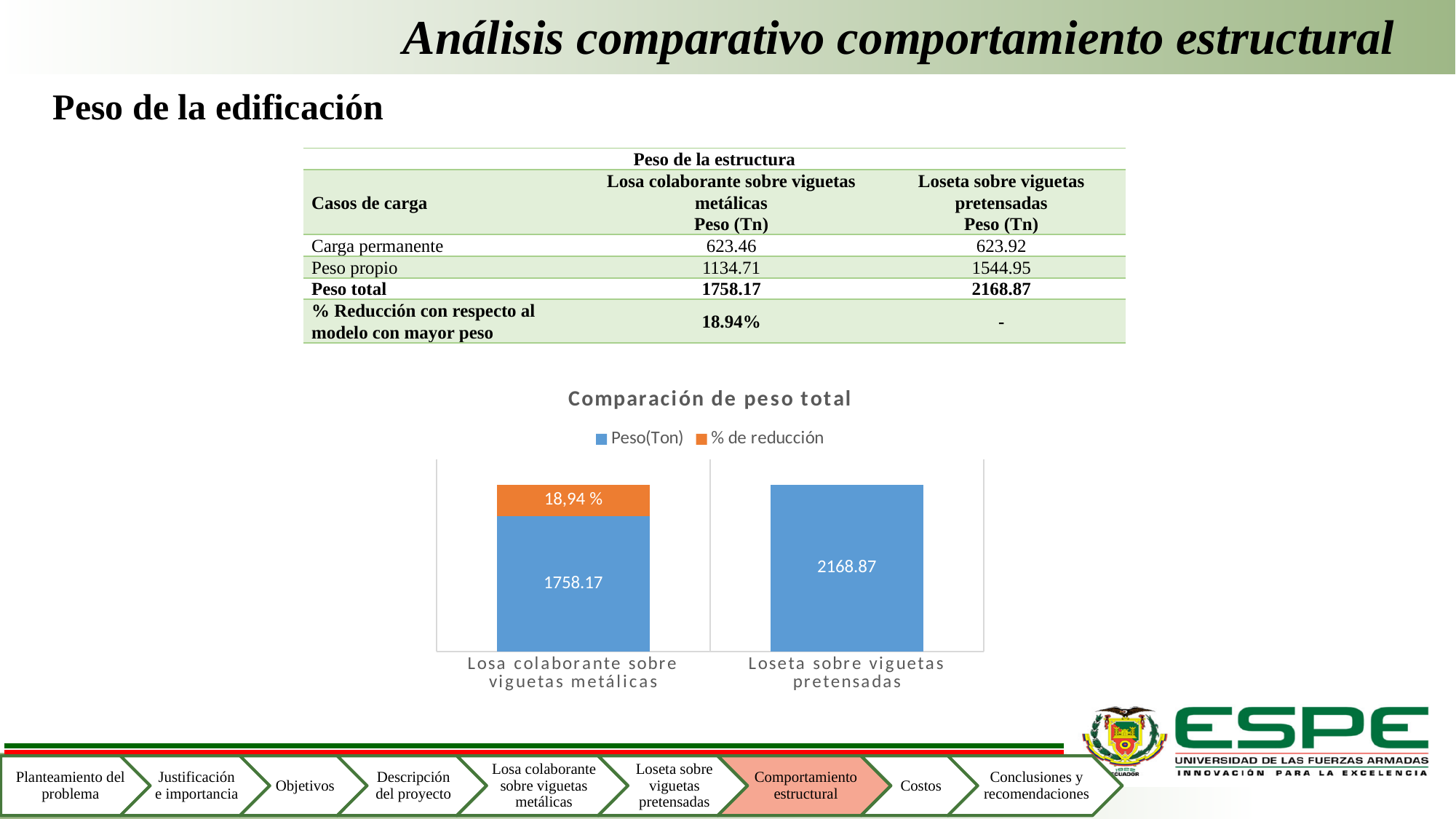
Which has a larger Peso(Ton) value: Losa colaborante sobre viguetas metálicas or Loseta sobre viguetas pretensadas? Loseta sobre viguetas pretensadas What is the difference in Peso(Ton) between Loseta sobre viguetas pretensadas and Losa colaborante sobre viguetas metálicas? 410.70 How many series does the chart legend list? 2 What kind of chart is shown on the slide? Stacked bar chart Which category has the lowest Peso(Ton) value in the chart? Losa colaborante sobre viguetas metálicas How many categories are shown on the x axis of the chart? 2 What is the title of the chart? Comparación de peso total What is the Peso(Ton) value for Losa colaborante sobre viguetas metálicas in the chart? 1758.17 What is the Peso(Ton) value for Loseta sobre viguetas pretensadas in the chart? 2168.87 Which series is shown in orange in the chart? % de reducción What is the % de reducción label shown on the bar for Losa colaborante sobre viguetas metálicas? 18,94 % Which category has the highest Peso(Ton) value in the chart? Loseta sobre viguetas pretensadas